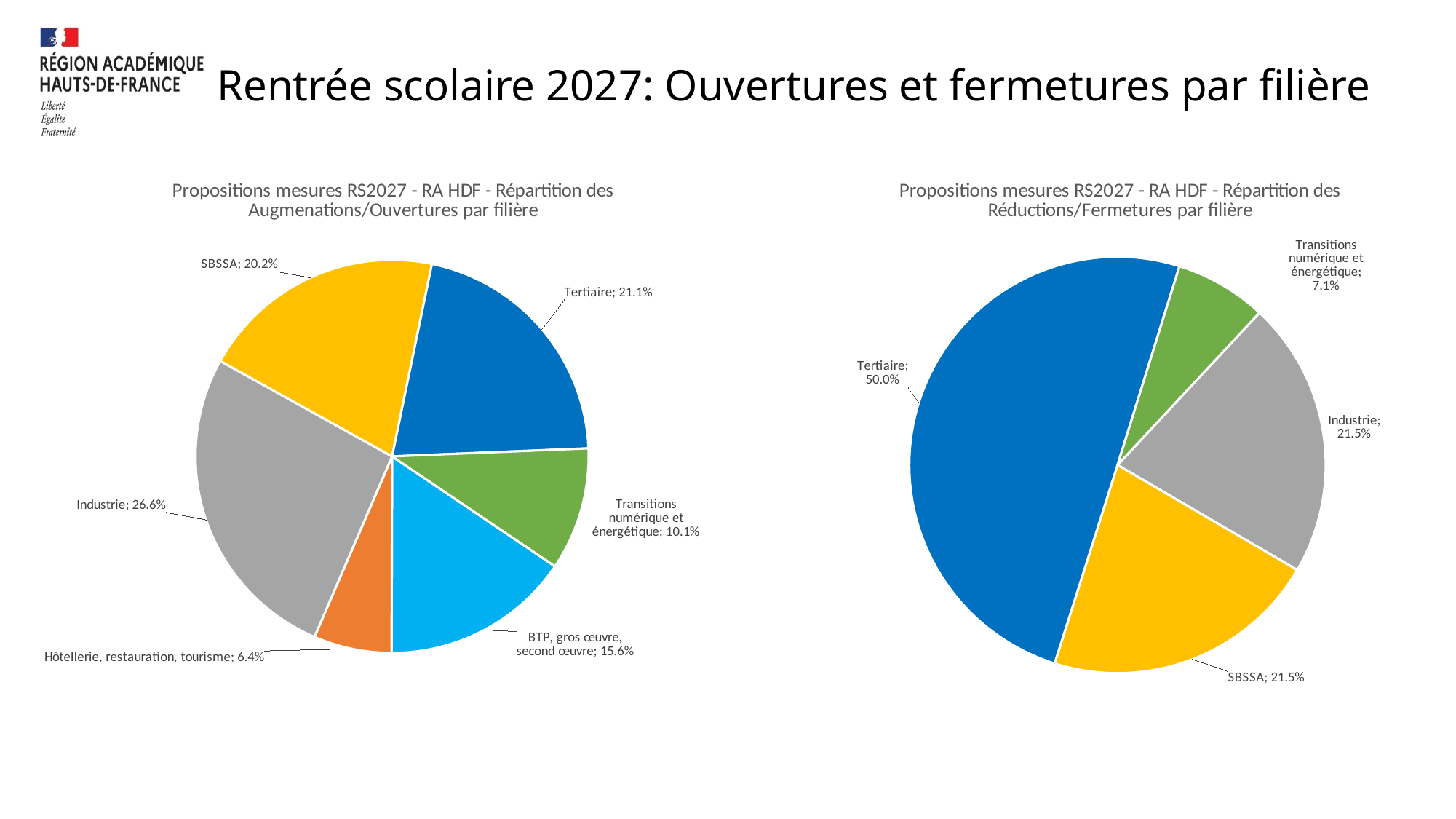
In the right chart (Réductions/Fermetures par filière), how many slices does the pie have? 4 In the left chart (Augmentations/Ouvertures par filière), what share does Industrie have? 26.6% In the left chart (Augmentations/Ouvertures par filière), which is larger: BTP, gros œuvre, second œuvre or Transitions numérique et énergétique? BTP, gros œuvre, second œuvre In the right chart (Réductions/Fermetures par filière), what is the difference between the shares of Industrie and Transitions numérique et énergétique? 14.4% In the left chart (Augmentations/Ouvertures par filière), what is the difference between the shares of Tertiaire and SBSSA? 0.9% In the right chart (Réductions/Fermetures par filière), what share does Transitions numérique et énergétique have? 7.1% In the left chart (Augmentations/Ouvertures par filière), which filière has the smallest share? Hôtellerie, restauration, tourisme In the left chart (Augmentations/Ouvertures par filière), what share does Hôtellerie, restauration, tourisme have? 6.4% What type of chart is used on the right side of the slide? Pie chart In the left chart (Augmentations/Ouvertures par filière), how many slices does the pie have? 6 In the right chart (Réductions/Fermetures par filière), what share does Tertiaire have? 50.0% In the left chart (Augmentations/Ouvertures par filière), which filière has the largest share? Industrie